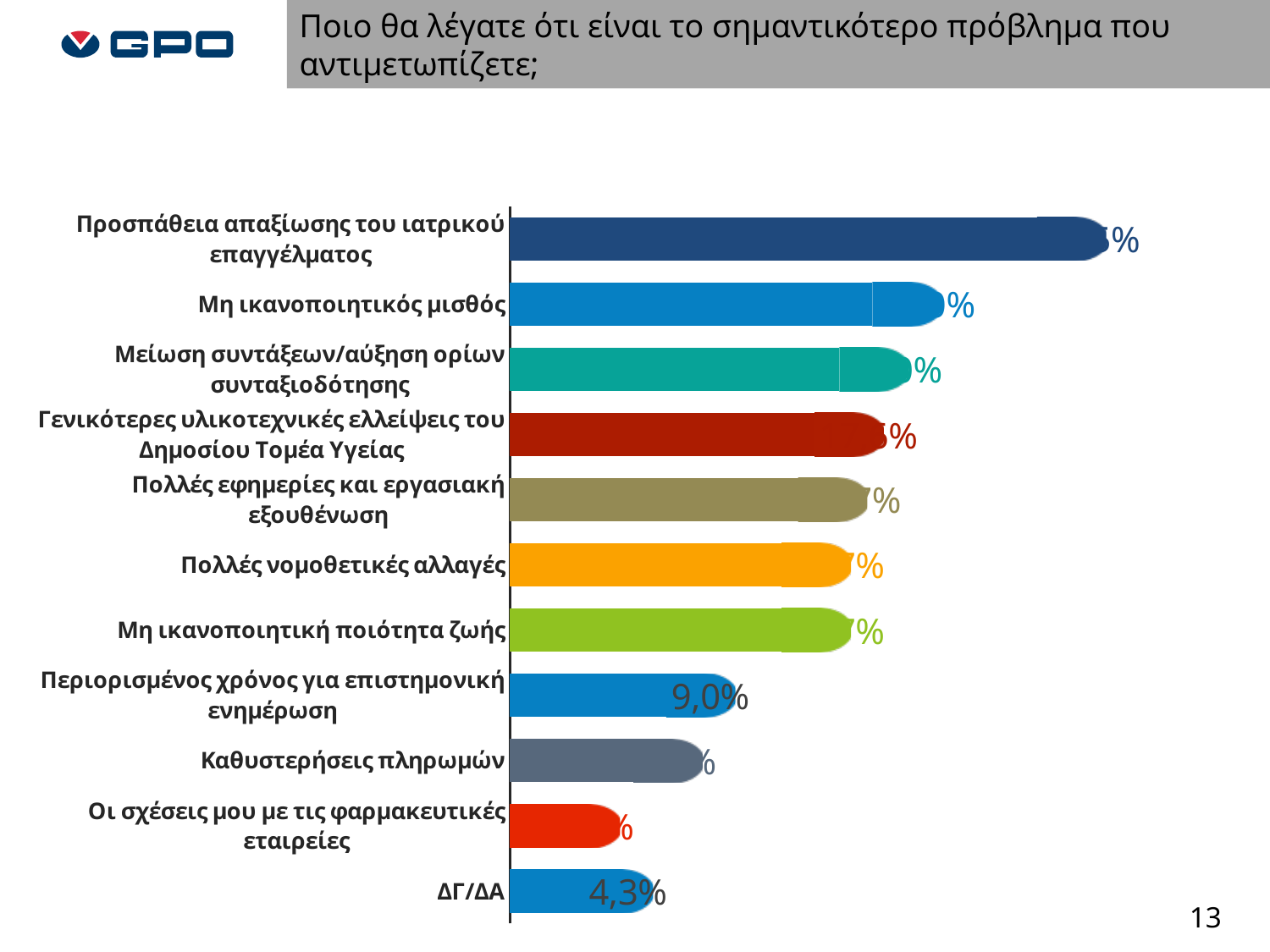
What is the value for 'Περιορισμένος χρόνος για επιστημονική ενημέρωση'? 9,0% What is the difference between the values for 'Περιορισμένος χρόνος για επιστημονική ενημέρωση' and 'ΔΓ/ΔΑ'? 4,7% How many categories (bars) does the chart show? 11 Which is larger: the value for 'Μείωση συντάξεων/αύξηση ορίων συνταξιοδότησης' or the value for 'Μη ικανοποιητική ποιότητα ζωής'? Μείωση συντάξεων/αύξηση ορίων συνταξιοδότησης Which is larger: the value for 'Μη ικανοποιητικός μισθός' or the value for 'Καθυστερήσεις πληρωμών'? Μη ικανοποιητικός μισθός What kind of chart is shown on the slide? bar chart Which is larger: the value for 'Οι σχέσεις μου με τις φαρμακευτικές εταιρείες' or the value for 'Πολλές νομοθετικές αλλαγές'? Πολλές νομοθετικές αλλαγές Which category has the highest value in the chart? Προσπάθεια απαξίωσης του ιατρικού επαγγέλματος What is the value for 'ΔΓ/ΔΑ'? 4,3% What is the title of the slide containing the chart? Ποιο θα λέγατε ότι είναι το σημαντικότερο πρόβλημα που αντιμετωπίζετε; Which category has the lowest value in the chart? Οι σχέσεις μου με τις φαρμακευτικές εταιρείες